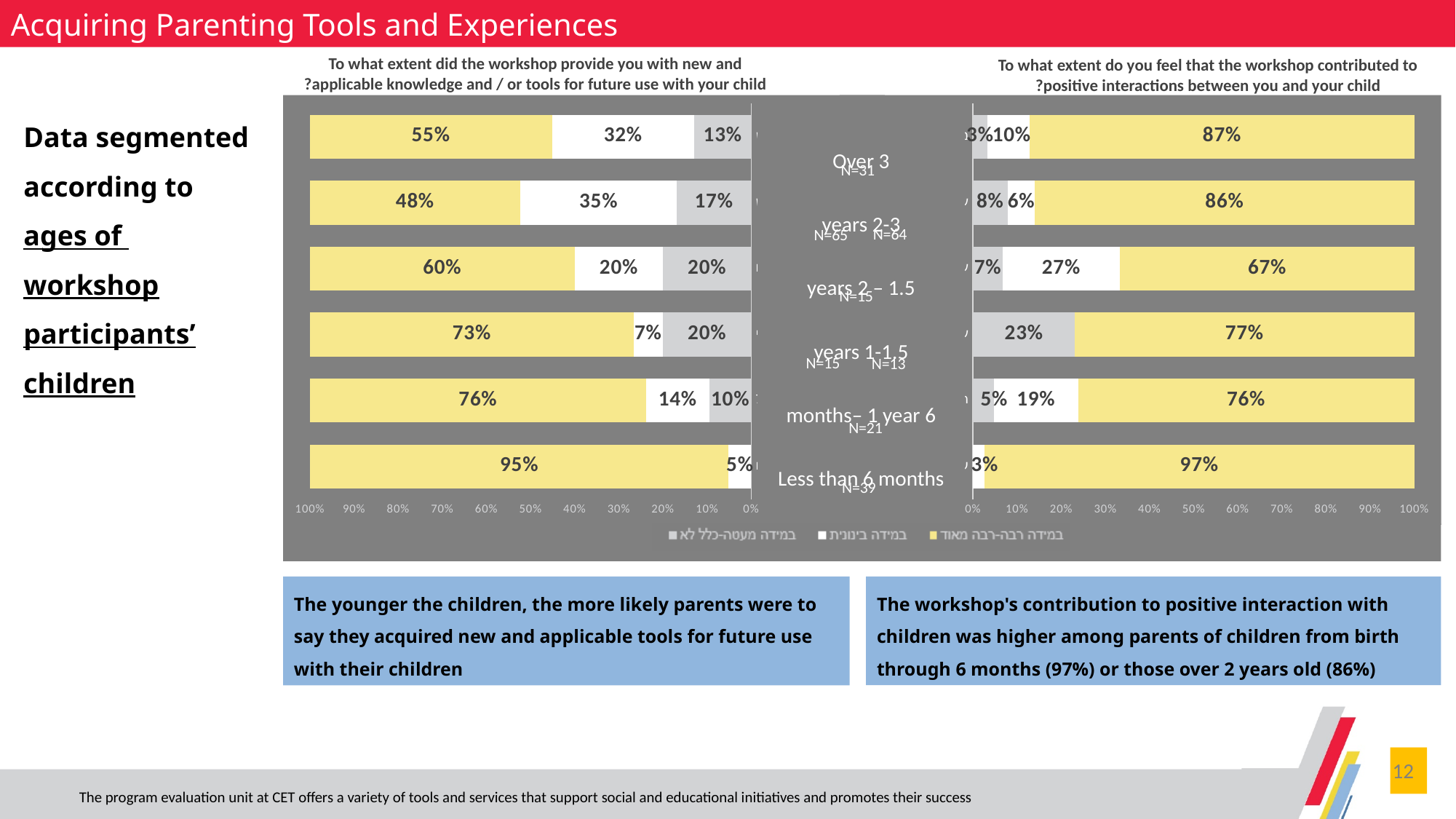
In the left chart, which age group has the largest yellow segment? Less than 6 months In the right chart (positive interactions), what percentage is shown for the yellow segment of the 'Less than 6 months' bar? 97% How many series does the legend list? 3 In the left chart (new and applicable knowledge/tools), what percentage is shown for the yellow segment of the 'Less than 6 months' bar? 95% In the left chart, how many percentage points larger is the yellow segment for 'Less than 6 months' than for 'Over 3'? 40 percentage points In the left chart, what percentage is shown for the yellow segment of the 'Over 3' bar at the top? 55% In the left chart, which age group has the smallest yellow segment? 2-3 years In the left chart, what is the total of the three segments of the 'Over 3' bar (55%, 32%, 13%)? 100% In the right chart, which has the larger yellow segment: 'Less than 6 months' or 'Over 3'? Less than 6 months What type of chart is used on this slide? Bar chart How many age-group bars does the left chart contain? 6 In the right chart, what percentage is shown for the yellow segment of the 'Over 3' bar at the top? 87%